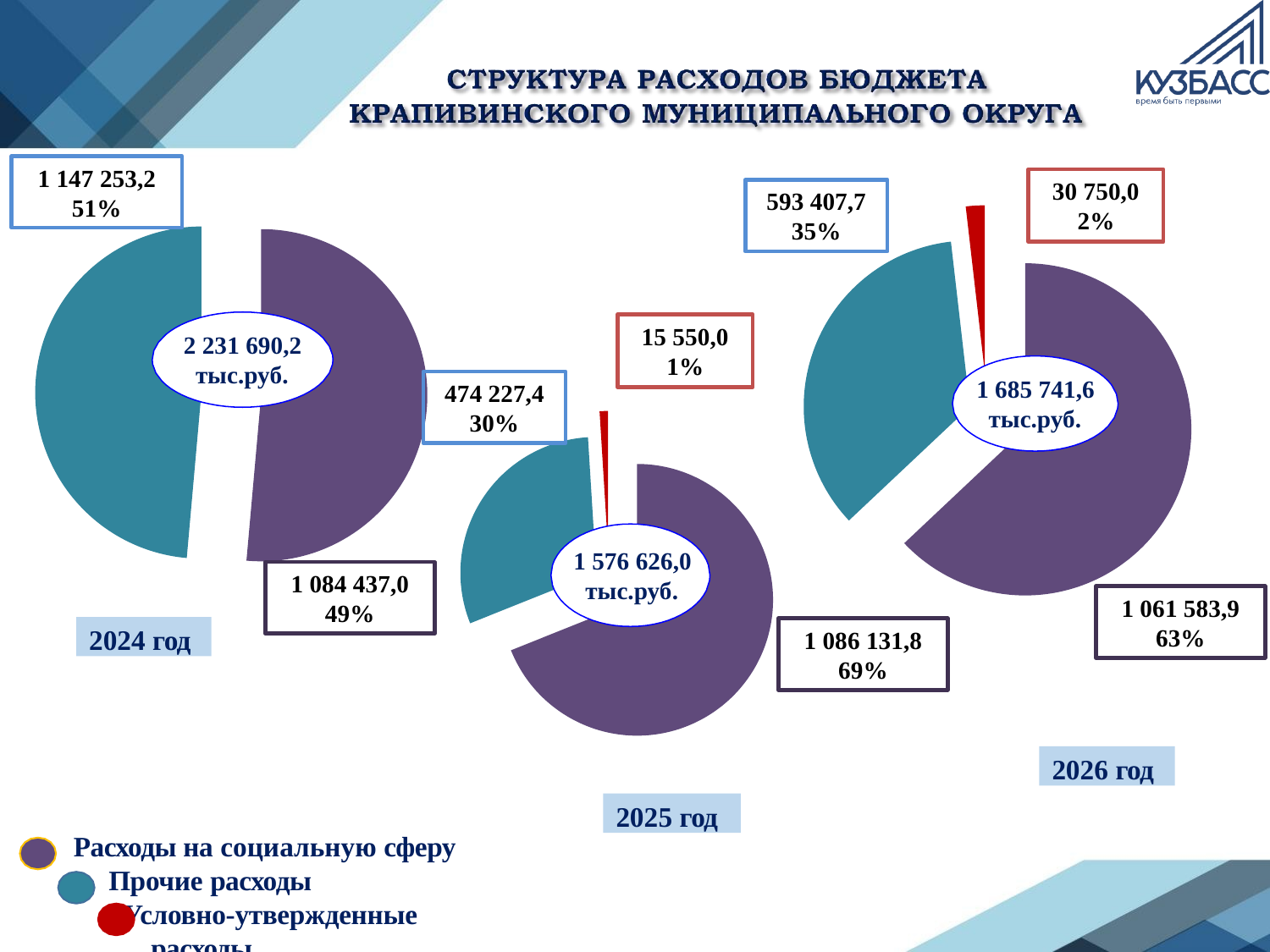
На диаграмме за 2024 год какова сумма расходов на социальную сферу? 1 084 437,0 На диаграмме за 2025 год какова сумма условно-утвержденных расходов? 15 550,0 На диаграмме за 2024 год что больше: расходы на социальную сферу или прочие расходы? Прочие расходы Какой тип диаграмм представлен на слайде? Круговые диаграммы Какой общий объём расходов указан в центре диаграммы за 2026 год? 1 685 741,6 тыс.руб. На диаграмме за 2026 год какую долю составляют расходы на социальную сферу? 63% На диаграмме за 2026 год какая категория расходов наименьшая? Условно-утвержденные расходы На диаграмме за 2024 год какую долю составляют прочие расходы? 51% Сколько категорий расходов перечислено в легенде? 3 Каким цветом на диаграммах обозначены условно-утвержденные расходы? Красным Сколько круговых диаграмм показано на слайде? 3 На диаграмме за 2025 год какая категория расходов наибольшая? Расходы на социальную сферу